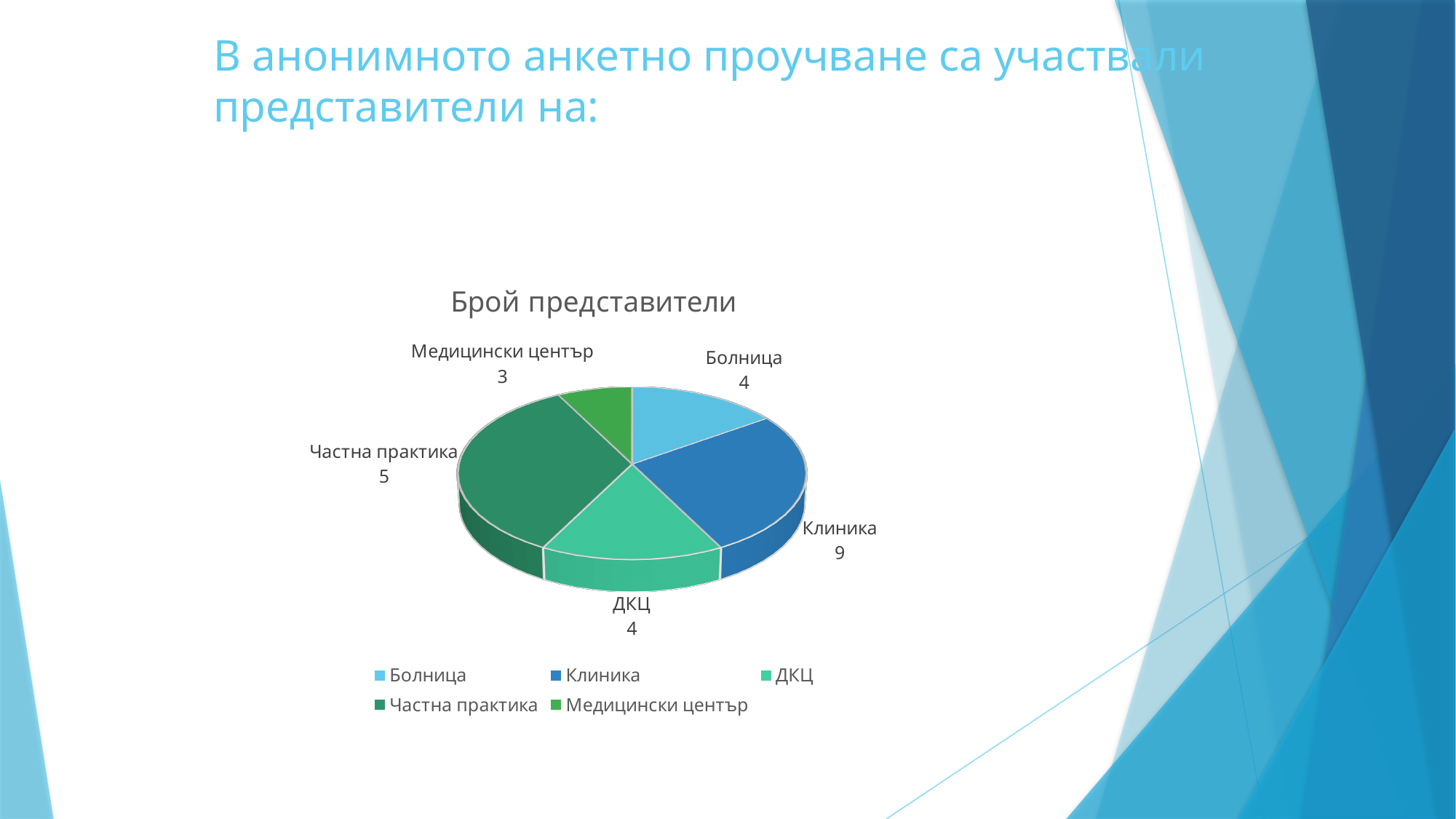
Which category has the highest value? Клиника What is the value for Клиника? 9 What type of chart is shown on the slide? pie chart What is the value for Медицински център? 3 Which is larger, the value for Частна практика or the value for Болница? Частна практика What is the total of all the values in the pie chart? 25 What share of the pie does Клиника represent? 36% What is the difference between the values for Клиника and Частна практика? 4 What is the title of the chart? Брой представители How many categories does the pie chart have? 5 What is the value for Частна практика? 5 Which category has the lowest value? Медицински център